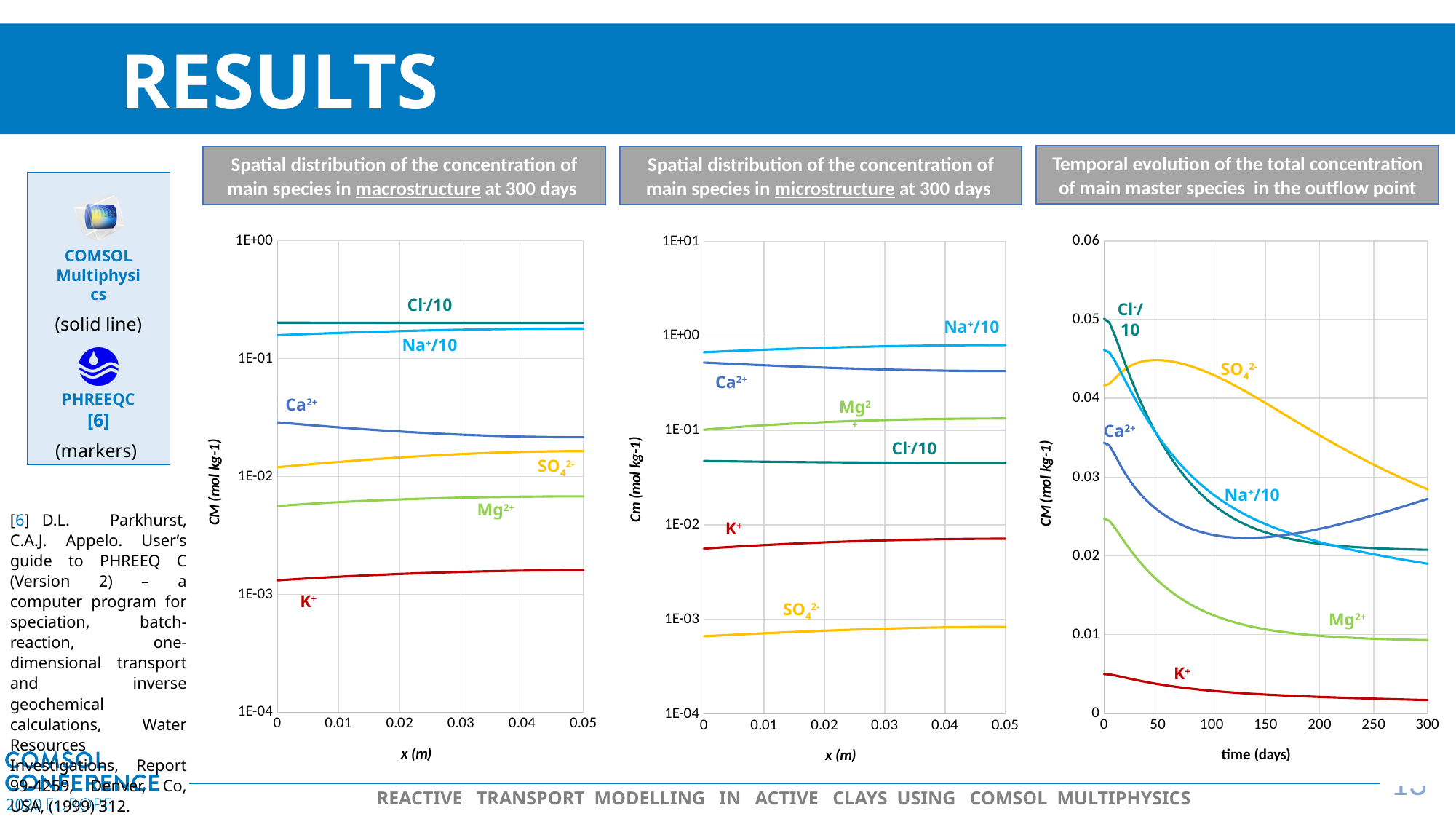
In the microstructure chart (middle), which is larger at x = 0.05: Ca2+ or Mg2+? Ca2+ In the macrostructure chart (left), is the value for Ca2+ at x = 0 greater or less than 1E-02? greater In the microstructure chart (middle), which species has the highest concentration? Na+/10 In the macrostructure chart (left), which species has the lowest concentration across the x range? K+ What kind of chart is the 'Spatial distribution of the concentration of main species in macrostructure at 300 days' chart? line chart In the temporal evolution chart (right), which species has the highest concentration at 300 days? SO4 2- In the temporal evolution chart (right), is the value for Ca2+ at time 0 greater or less than 0.03? greater In the macrostructure chart (left), is the value for K+ at x = 0 greater or less than 1E-02? less In the microstructure chart (middle), which species has the lowest concentration? SO4 2- In the macrostructure chart (left), which species has the highest concentration across the x range? Cl-/10 In the 'Temporal evolution of the total concentration of main master species in the outflow point' chart (right), does the Mg2+ curve rise or fall over time? fall